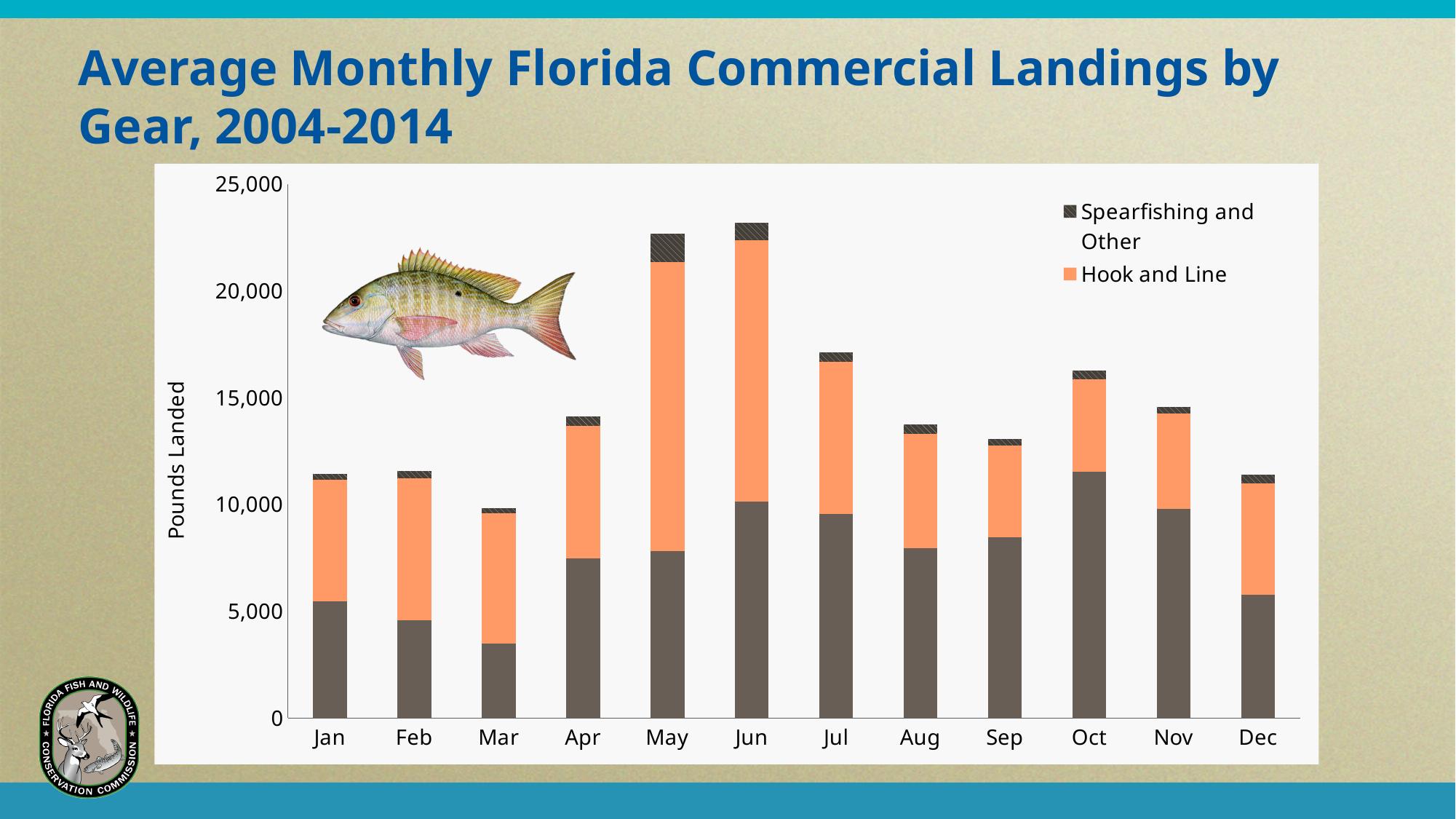
Do the total pounds landed rise or fall from Jun to Sep? fall Which month has the larger total pounds landed, May or Jan? May What colour represents Hook and Line in the chart? orange Which month has the lowest total pounds landed? Mar How many series does the chart's legend list? 2 Is the total pounds landed for Sep greater or less than 15,000? less Is the total pounds landed for Oct greater or less than 15,000? greater What is the label on the vertical axis of the chart? Pounds Landed Is the total pounds landed for Jun greater or less than 20,000? greater What kind of chart is shown on the slide? bar chart How many months are shown along the x axis of the chart? 12